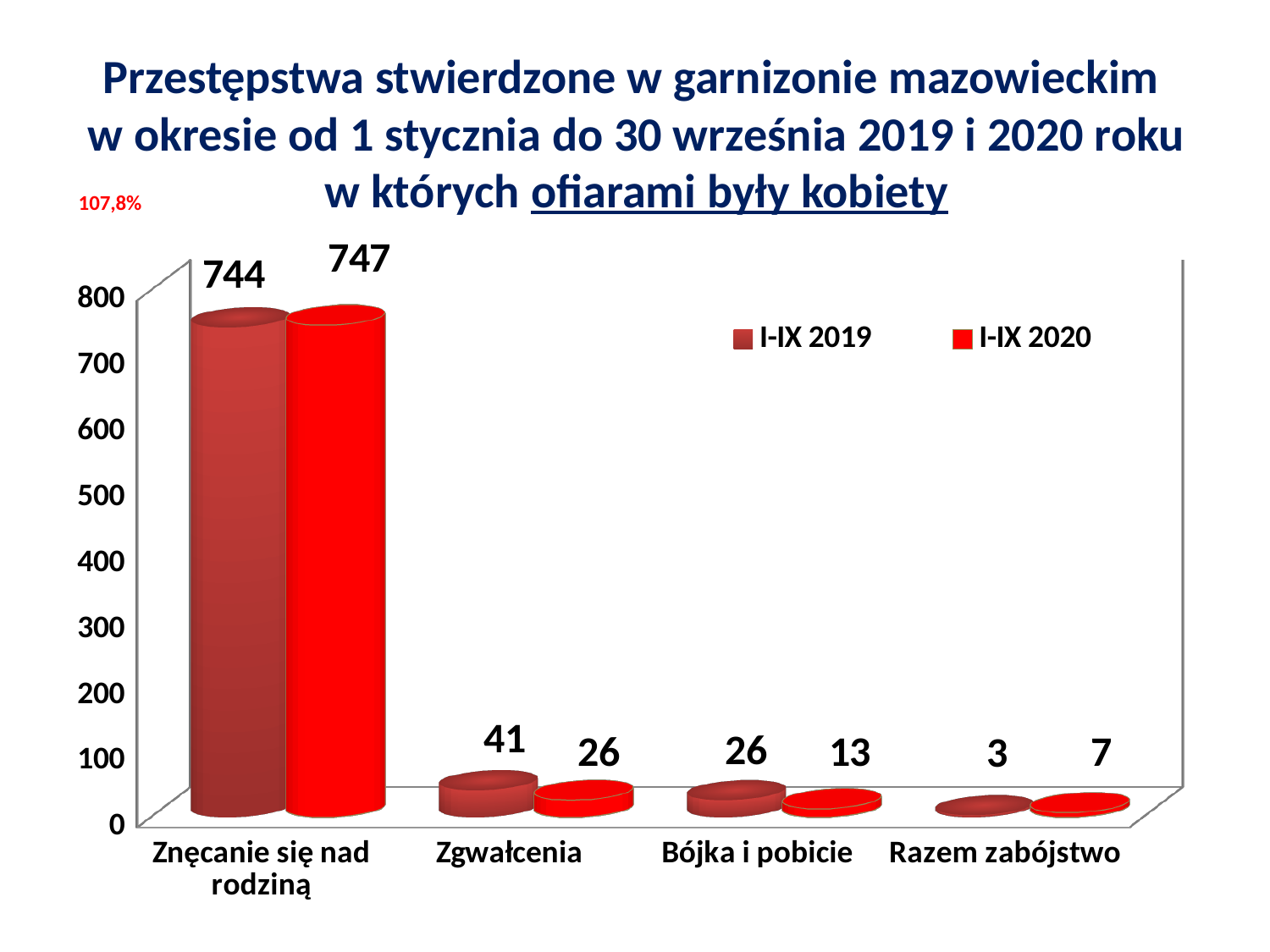
What is the value for Bójka i pobicie in the I-IX 2019 series? 26 Which category has the lowest value in the I-IX 2019 series? Razem zabójstwo What are the two series names listed in the legend? I-IX 2019 and I-IX 2020 What is the difference between the I-IX 2019 and I-IX 2020 values for Zgwałcenia? 15 How many categories are shown on the x axis? 4 Which is larger for Bójka i pobicie: the I-IX 2019 value or the I-IX 2020 value? I-IX 2019 How many series does the legend list? 2 What kind of chart is shown on the slide? Bar chart Which category has the highest value in the I-IX 2020 series? Znęcanie się nad rodziną What is the value for Znęcanie się nad rodziną in the I-IX 2019 series? 744 What is the value for Razem zabójstwo in the I-IX 2020 series? 7 What is the value for Zgwałcenia in the I-IX 2020 series? 26